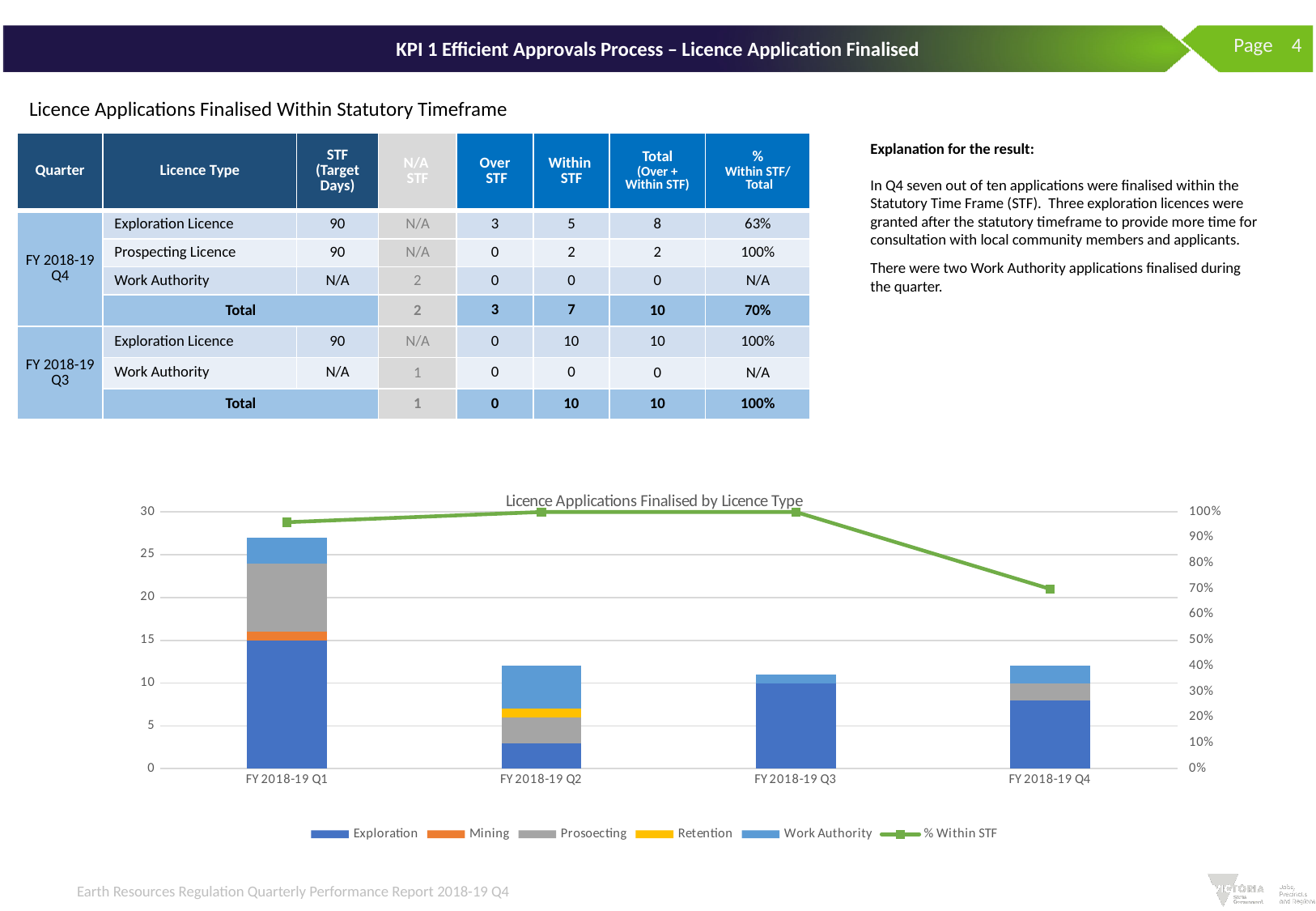
How many series does the chart legend list? 6 Which quarter has the lowest % Within STF value on the line? FY 2018-19 Q4 Is the % Within STF value for FY 2018-19 Q4 greater or less than 80%? less How many quarters are shown on the x axis of the chart? 4 What is the % Within STF value for FY 2018-19 Q3 on the chart? 100% Which stacked bar is taller, FY 2018-19 Q1 or FY 2018-19 Q2? FY 2018-19 Q1 Is the total stacked bar for FY 2018-19 Q1 greater or less than 25? greater Which quarter has the tallest stacked bar in the chart? FY 2018-19 Q1 What is the title of the chart on the slide? Licence Applications Finalised by Licence Type What kind of chart is "Licence Applications Finalised by Licence Type"? Bar chart (stacked bars with a line) Is the total stacked bar for FY 2018-19 Q4 greater or less than 15? less Does the % Within STF line rise or fall from FY 2018-19 Q3 to FY 2018-19 Q4? Fall